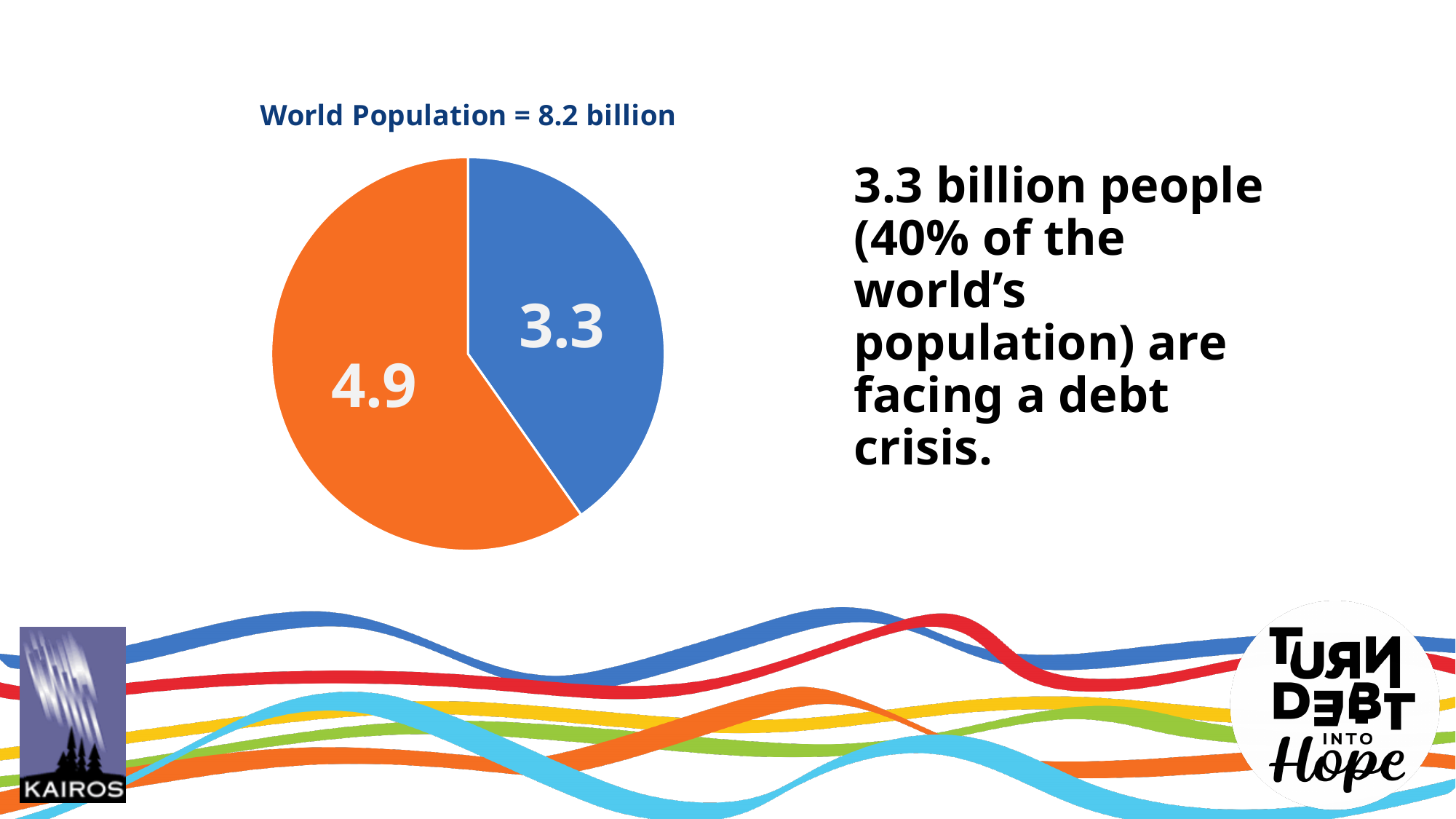
According to the slide, what share of the world's population does the 3.3 billion slice represent? 40% Which slice of the pie chart has the largest value? the orange slice (4.9) What kind of chart is shown on the slide? pie chart Which slice of the pie chart is larger, the blue one or the orange one? the orange one What colour is the slice representing the 3.3 billion people facing a debt crisis? blue What value is shown on the orange slice of the pie chart? 4.9 What value is shown on the blue slice of the pie chart? 3.3 What is the difference between the orange slice value and the blue slice value in the pie chart? 1.6 What is the title of the pie chart? World Population = 8.2 billion Which slice of the pie chart has the smallest value? the blue slice (3.3) How many slices does the pie chart have? 2 What is the total of the two slice values in the pie chart? 8.2